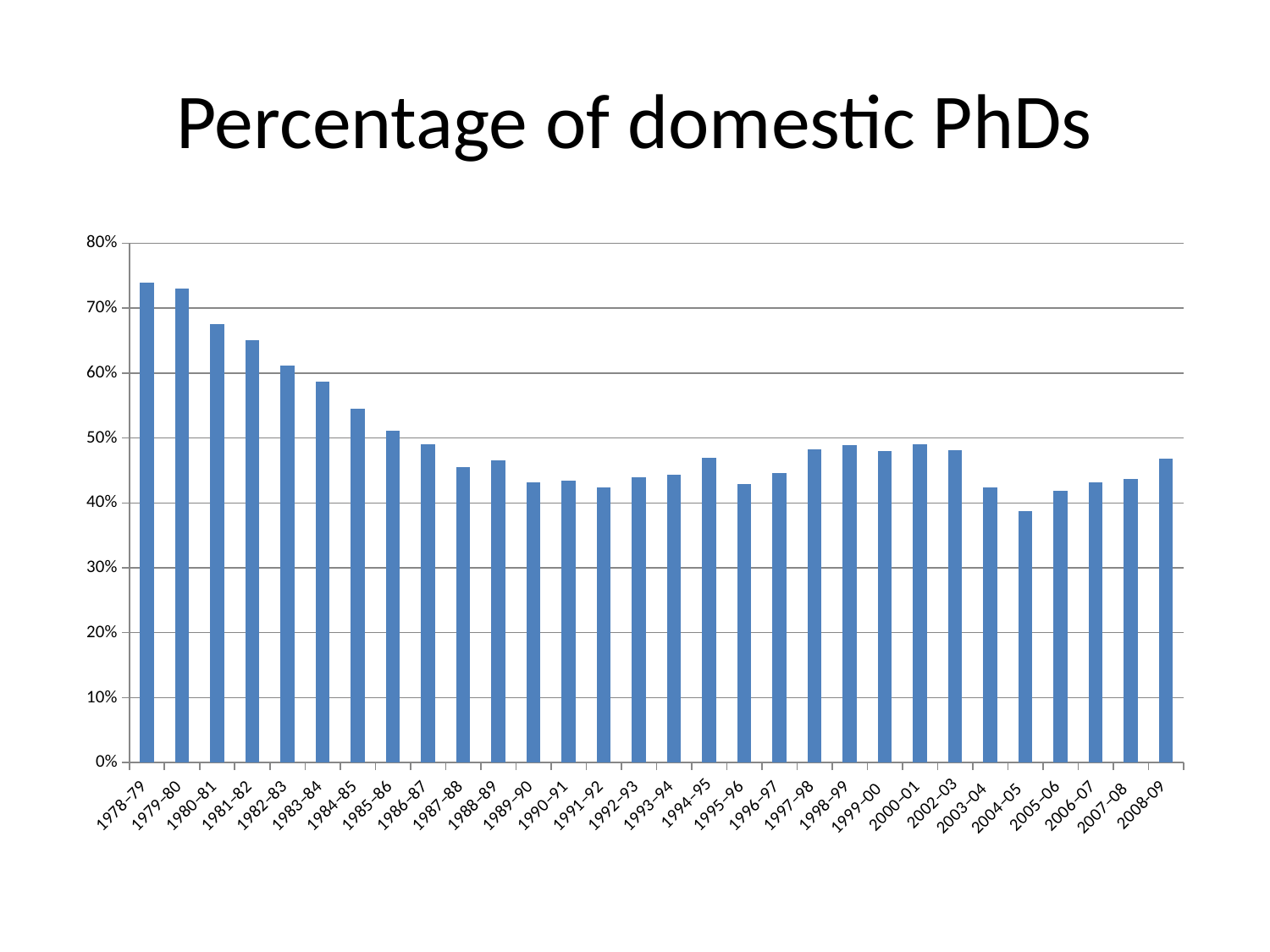
Is the value for 2004-05 greater or less than 40%? less Which academic year has the lowest percentage of domestic PhDs? 2004-05 Is the value for 1987-88 greater or less than 50%? less Do the values rise or fall from 1978-79 to 1989-90? fall Is the value for 1978-79 greater or less than 70%? greater What kind of chart is shown on the slide? bar chart How many bars (academic years) are plotted in the chart? 30 Which is larger, the value for 2004-05 or the value for 2008-09? 2008-09 What is the title of the chart? Percentage of domestic PhDs Which is larger, the value for 1980-81 or the value for 1990-91? 1980-81